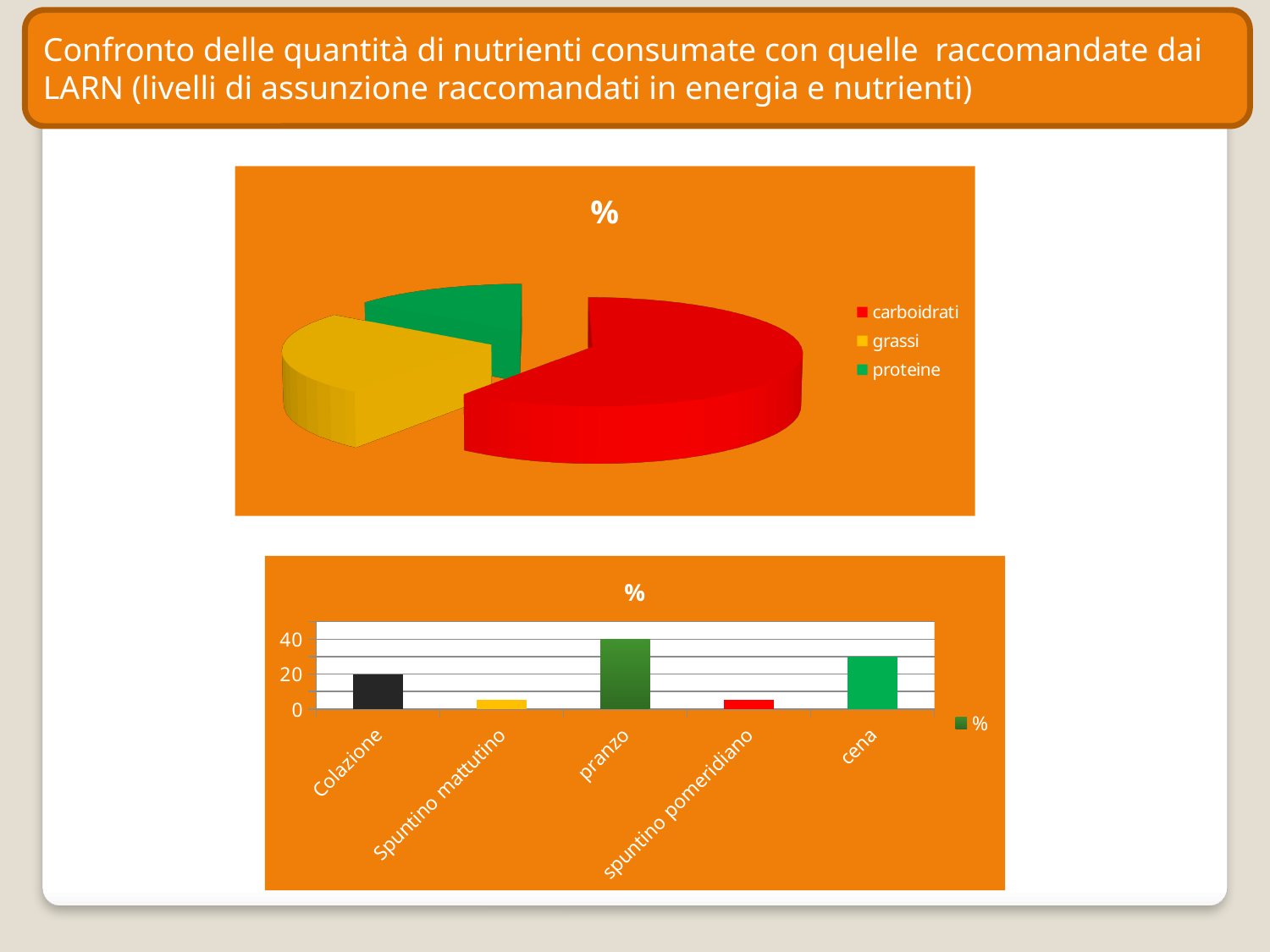
What kind of chart is the top chart on the slide? pie chart In the bottom bar chart, is the value for Spuntino mattutino greater or less than 20? less What kind of chart is the bottom chart on the slide? bar chart How many series does the legend of the bottom bar chart list? 1 In the top pie chart, which category has the largest slice? carboidrati How many categories are shown on the x axis of the bottom bar chart? 5 In the top pie chart, what colour is the slice for grassi? yellow How many slices does the top pie chart have? 3 In the bottom bar chart, which category has the highest bar? pranzo In the top pie chart, which category has the smallest slice? proteine In the bottom bar chart, is the value for cena greater or less than 20? greater In the bottom bar chart, which is larger, the value for cena or the value for Colazione? cena